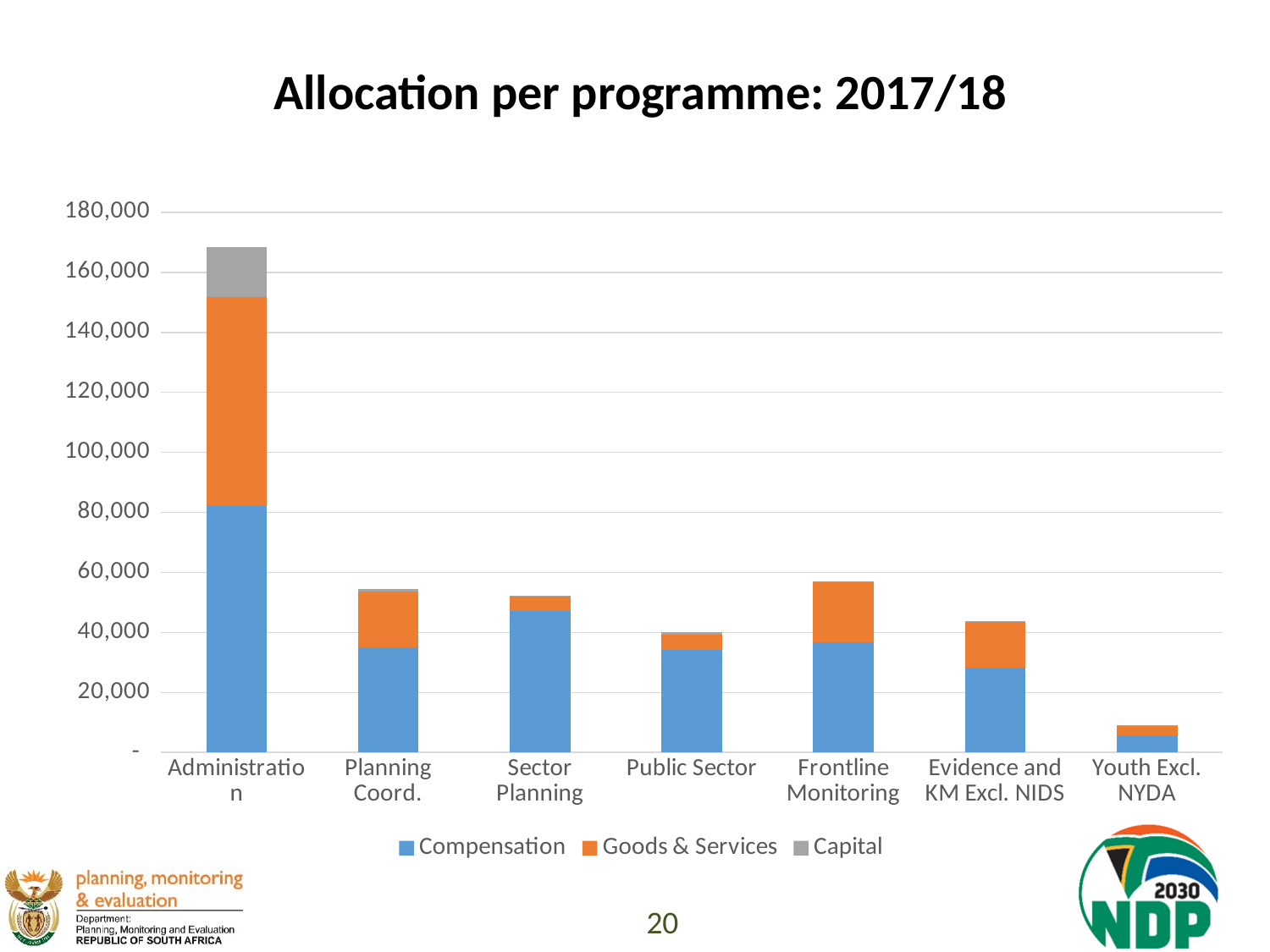
Is the total allocation for Youth Excl. NYDA greater or less than 20,000? less Which is larger, the Compensation value for Sector Planning or the Compensation value for Planning Coord.? Sector Planning Which programme has the largest Capital segment? Administration Which programme has the lowest total allocation? Youth Excl. NYDA What kind of chart is shown on the slide? Stacked bar chart What is the title of the chart? Allocation per programme: 2017/18 Is the total allocation for Administration greater or less than 160,000? greater How many series does the legend list? 3 Is the total allocation for Planning Coord. greater or less than 60,000? less Which programme has the highest total allocation? Administration How many programmes (categories) are shown on the x axis? 7